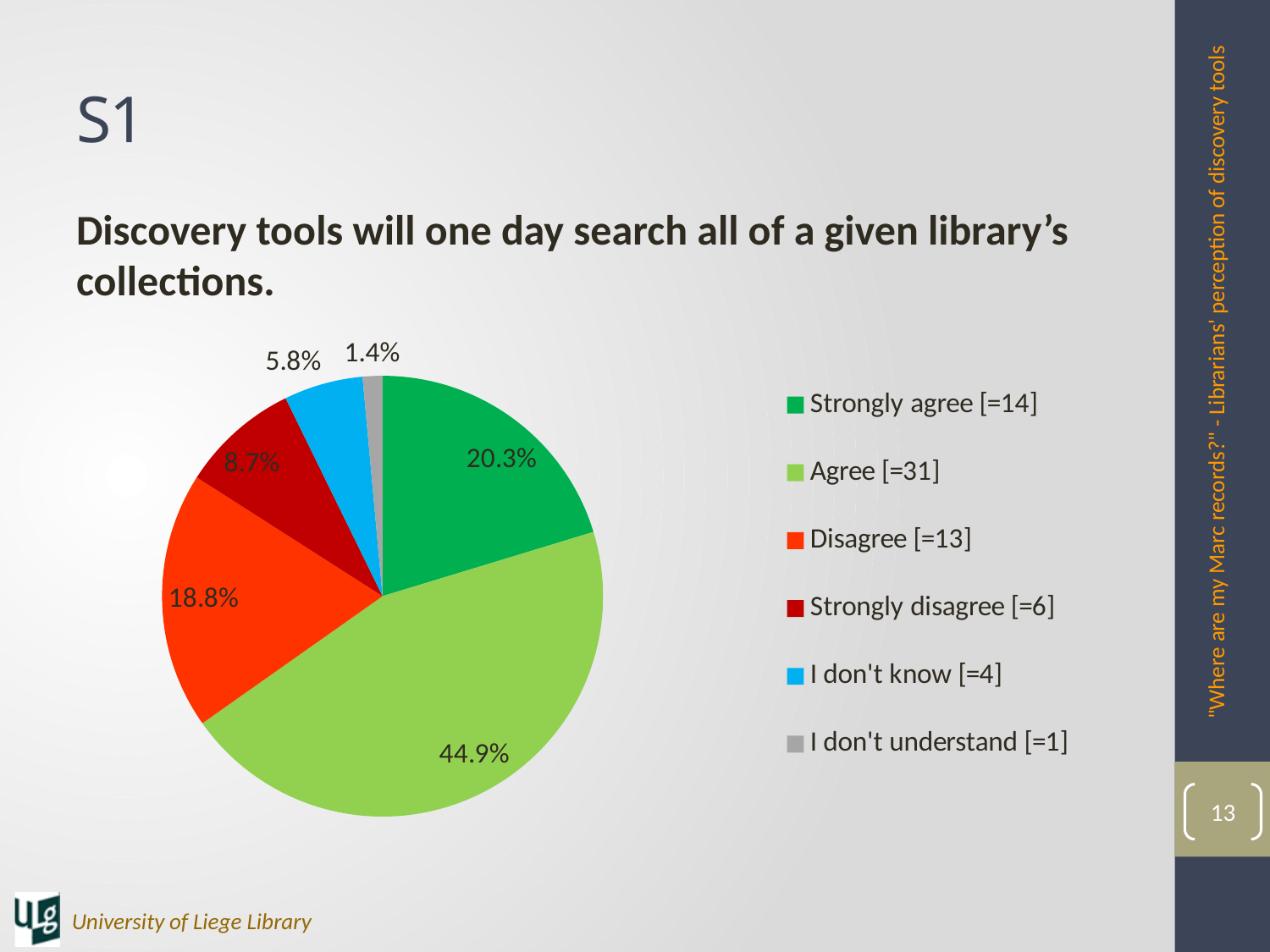
What kind of chart is shown on the slide? pie chart What is the difference in percentage points between the Agree and Strongly agree slices? 24.6 How many respondents does the legend show for Disagree? 13 Which category has the smallest slice of the pie? I don't understand Which is larger, the Strongly agree slice or the Disagree slice? Strongly agree What percentage is shown for Strongly disagree? 8.7% How many categories does the pie chart have? 6 What share of the pie does the Agree slice represent? 44.9% Which category has the largest slice of the pie? Agree What percentage is shown for Strongly agree? 20.3% What percentage is shown for I don't know? 5.8% What percentage is shown for Disagree? 18.8%